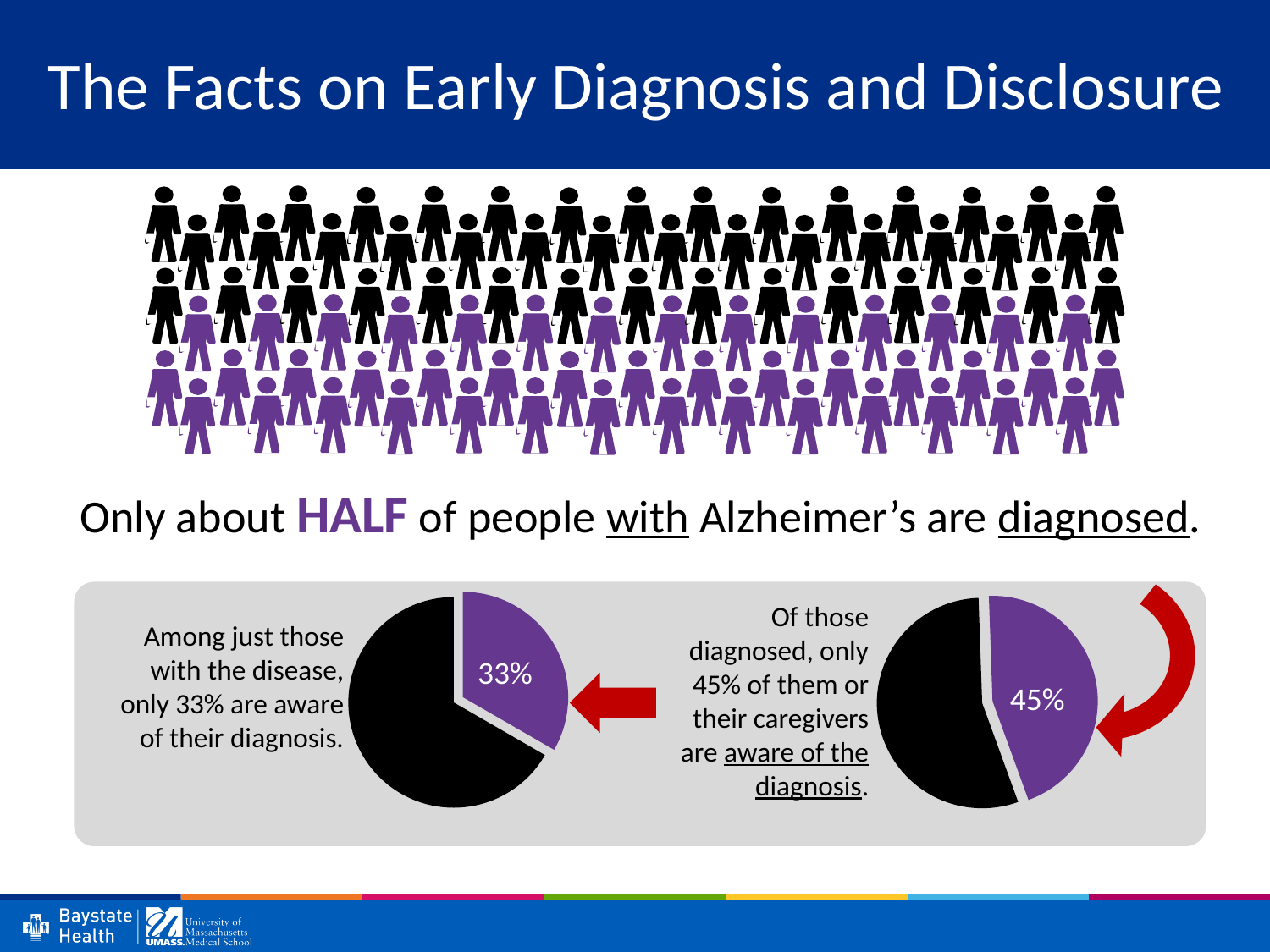
In the left pie chart, what share of the pie does the purple slice represent? 33% In the left pie chart, what value is printed on the purple slice? 33% What colour is the slice labelled 45% in the right pie chart? purple What is the difference between the purple slice of the right pie chart and the purple slice of the left pie chart? 12% Which pie chart has the larger purple slice, the left one or the right one? the right one In the right pie chart, which slice is larger, the black slice or the purple slice? the black slice How many slices does the left pie chart have? 2 In the right pie chart, what share of the pie does the purple slice represent? 45% In the left pie chart, which slice is larger, the black slice or the purple slice? the black slice In the right pie chart, what value is printed on the purple slice? 45% What kind of chart is the right chart in the grey box? pie chart What kind of chart is the left chart in the grey box? pie chart